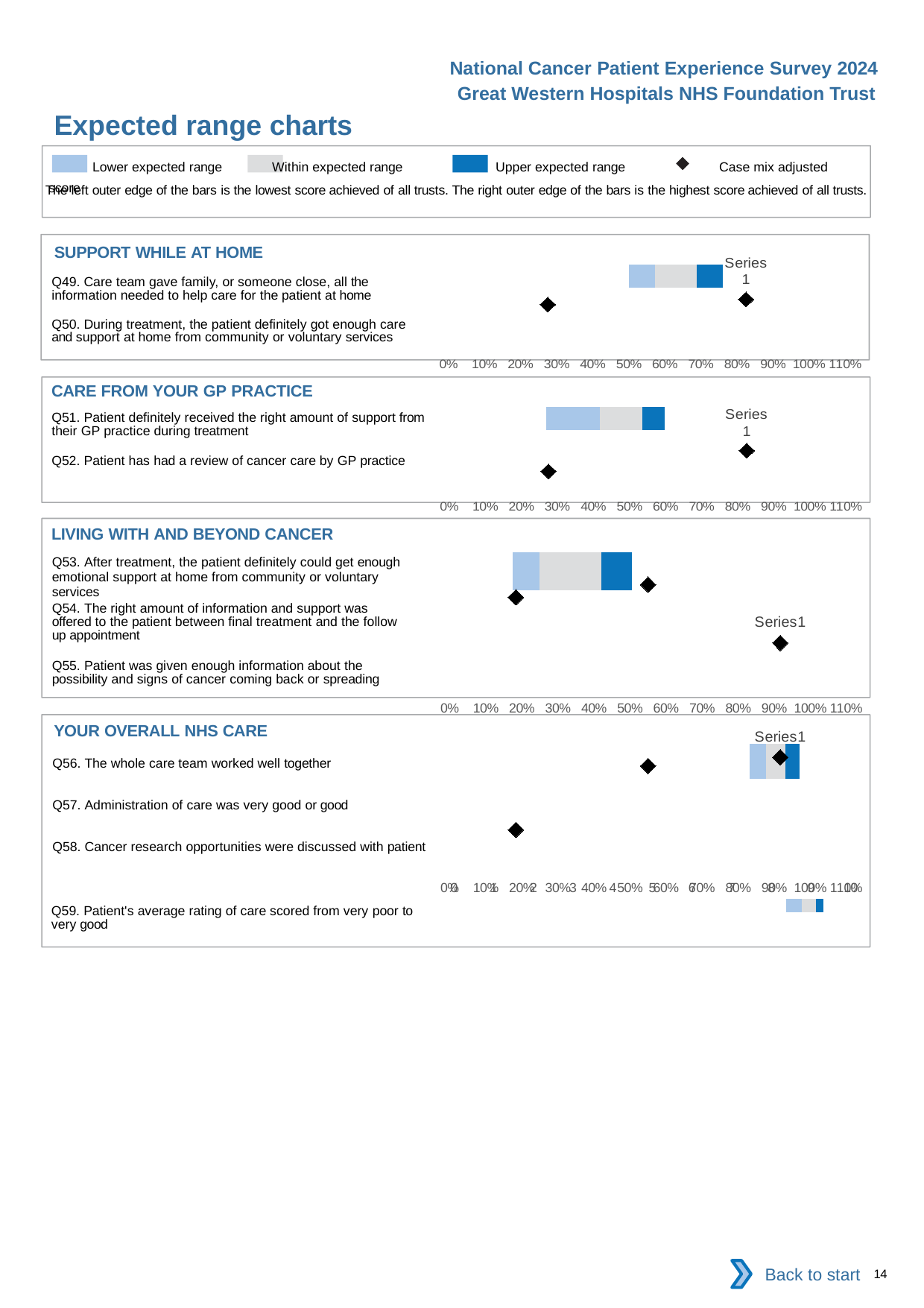
How many question categories are listed in the LIVING WITH AND BEYOND CANCER chart? 3 In the YOUR OVERALL NHS CARE chart, is the value for the rightmost case mix adjusted score marker greater or less than 80%? greater How many entries does the legend at the top of the slide list? 4 How many question categories are listed in the CARE FROM YOUR GP PRACTICE chart? 2 Which legend entry is shown with a black diamond marker? Case mix adjusted score In the CARE FROM YOUR GP PRACTICE chart, is the value for the rightmost case mix adjusted score marker greater or less than 70%? greater In the SUPPORT WHILE AT HOME chart, is the value for the rightmost case mix adjusted score marker greater or less than 70%? greater What is the highest tick label on the x axis of the SUPPORT WHILE AT HOME chart? 110% How many question categories are listed in the YOUR OVERALL NHS CARE chart? 4 What kind of chart is used in the SUPPORT WHILE AT HOME section? bar chart